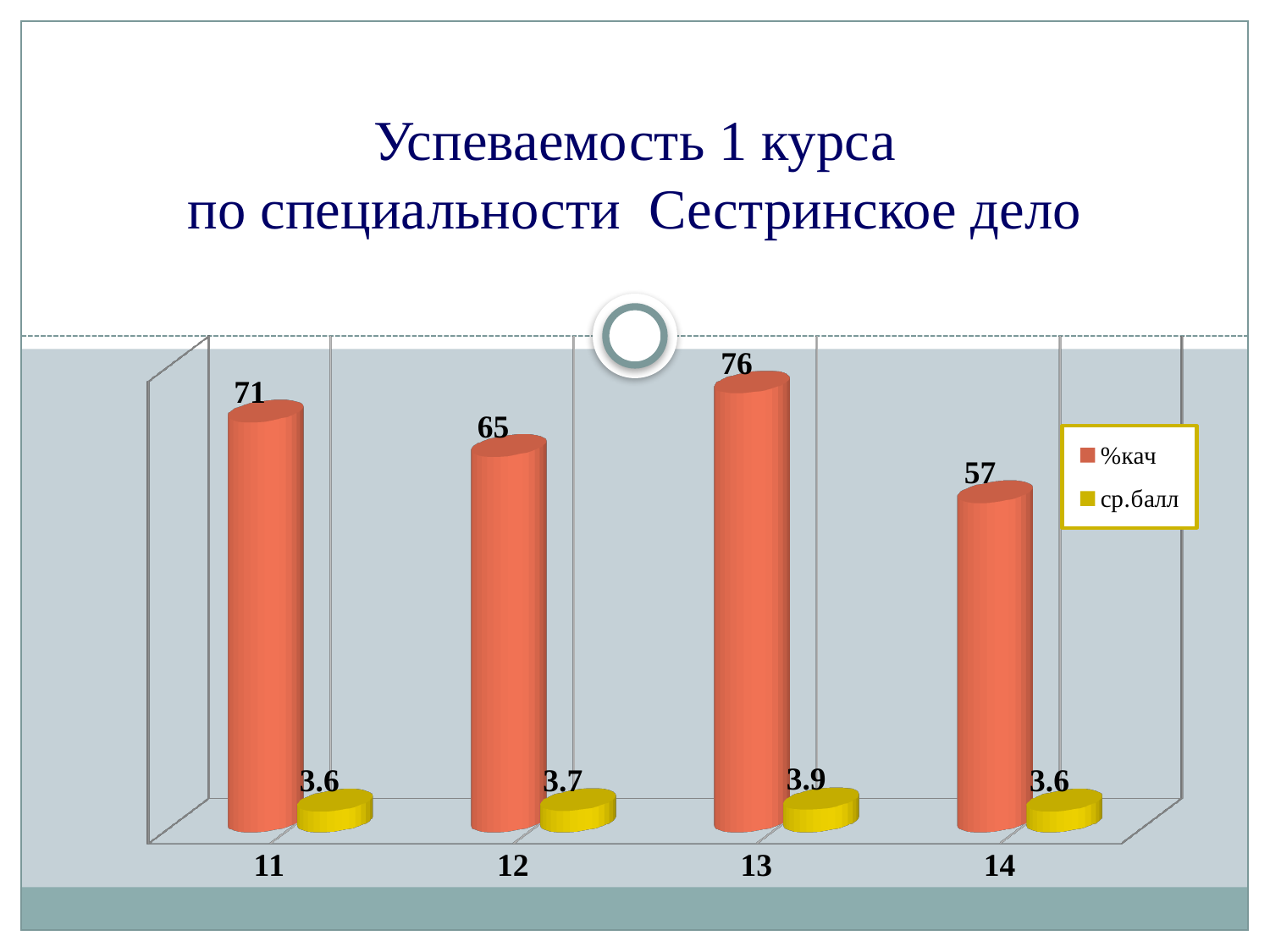
Which category has the highest ср.балл value? 13 What kind of chart is shown on the slide? bar chart Which is larger, the %кач value for category 11 or for category 12? 11 What are the two series named in the legend? %кач and ср.балл What is the %кач value for category 13? 76 Which category has the highest %кач value? 13 What is the difference between the %кач values for categories 13 and 14? 19 How many categories are shown on the x axis? 4 Which category has the lowest %кач value? 14 How many series does the legend list? 2 What is the ср.балл value for category 12? 3.7 What is the %кач value for category 14? 57